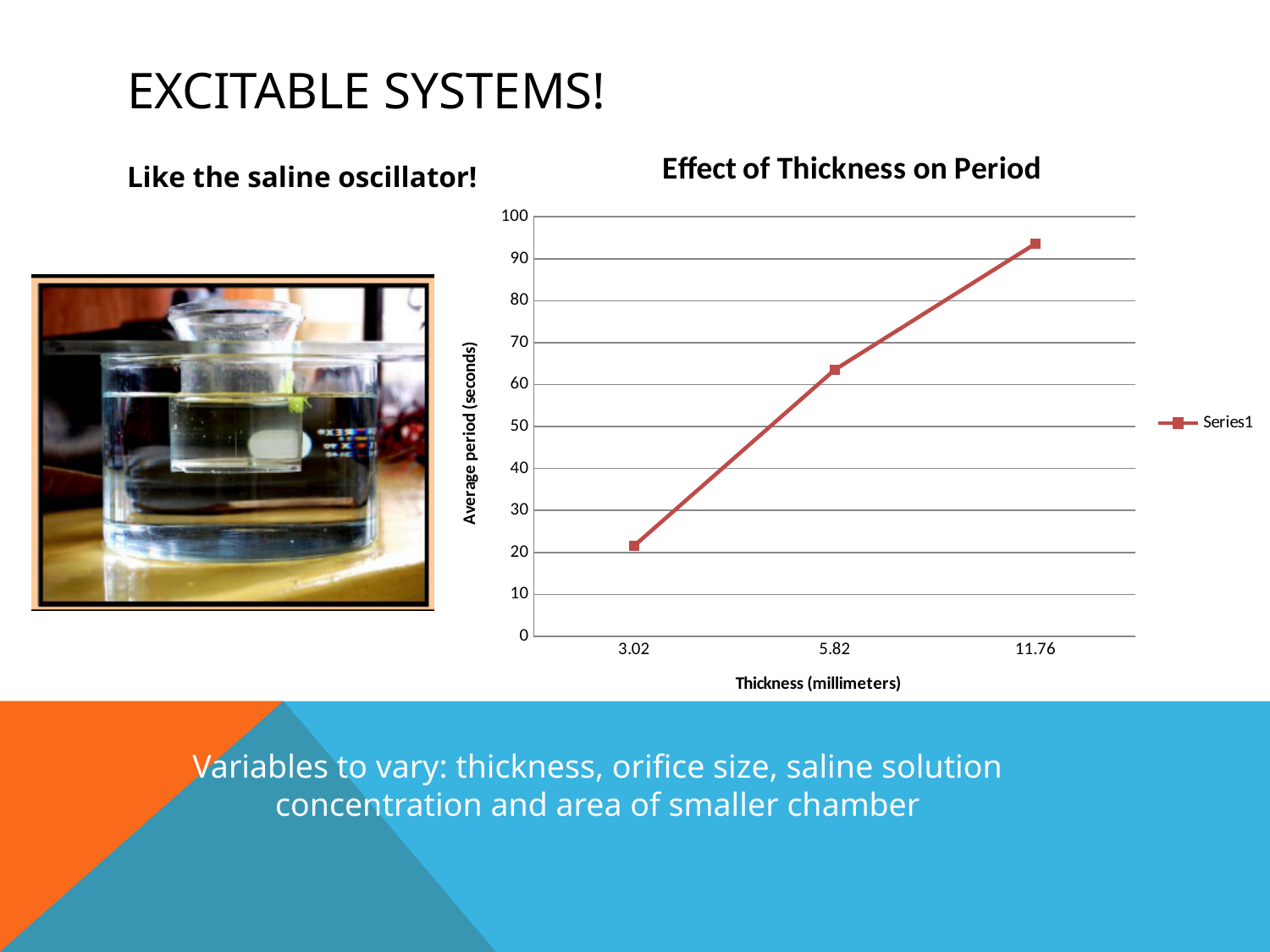
Is the average period for a thickness of 11.76 greater or less than 90? greater Which thickness has the lowest average period? 3.02 Which thickness has the highest average period? 11.76 Does the average period rise or fall as thickness increases along the x axis? rise How many series does the legend list? 1 What is the label of the y axis? Average period (seconds) Which has a larger average period, a thickness of 5.82 or 11.76? 11.76 What kind of chart is shown on the slide? line chart How many data points are plotted on the chart? 3 Is the average period for a thickness of 3.02 greater or less than 30? less What is the title of the chart? Effect of Thickness on Period Is the average period for a thickness of 5.82 greater or less than 60? greater